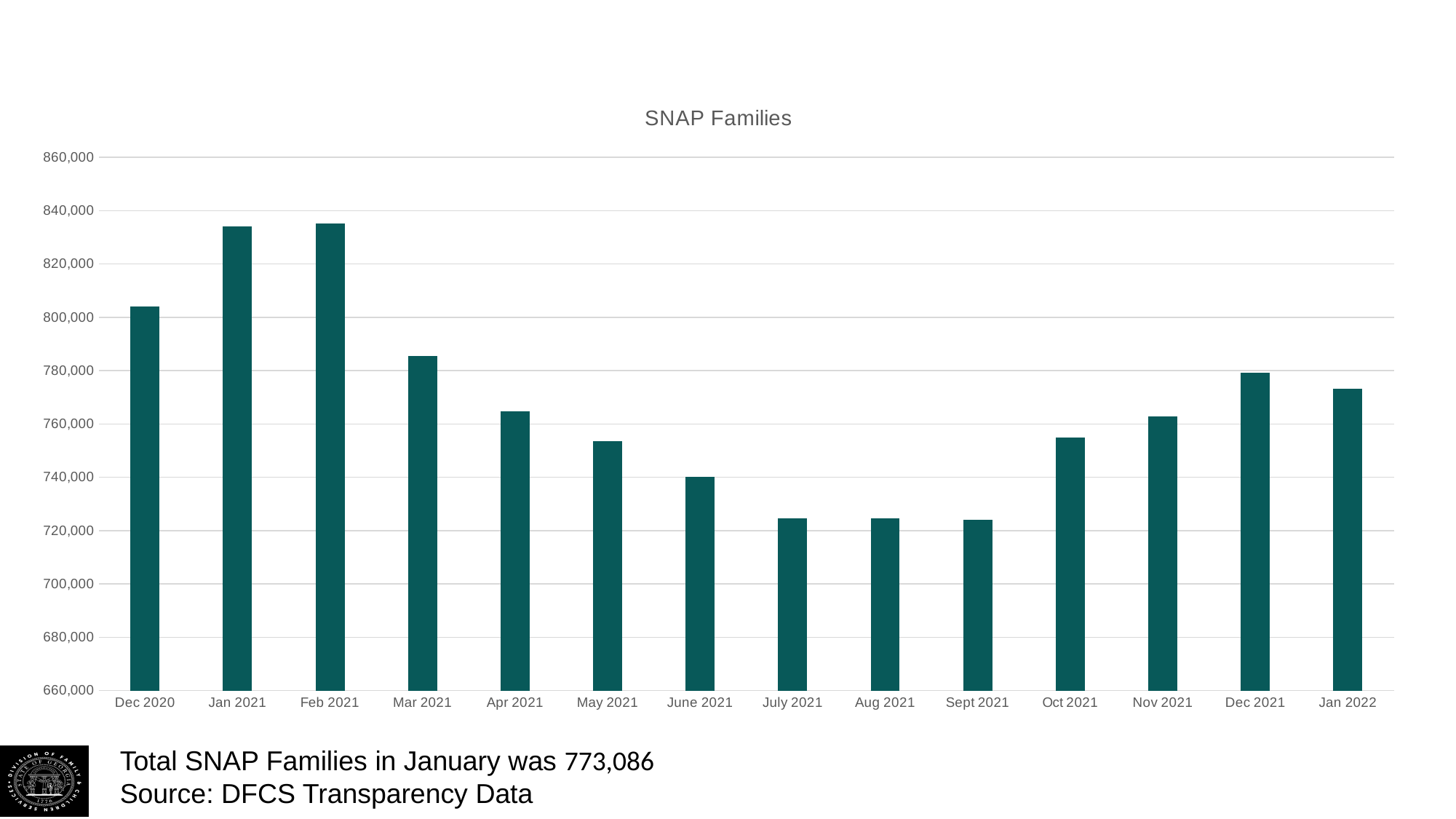
What is the title of the chart? SNAP Families Is the value for Nov 2021 greater or less than 760,000? greater Which is larger, the value for Oct 2021 or the value for Nov 2021? Nov 2021 Which is larger, the value for Dec 2020 or the value for Mar 2021? Dec 2020 What source is cited for the chart data? DFCS Transparency Data What was the total number of SNAP Families in Jan 2022? 773,086 Is the value for July 2021 greater or less than 740,000? less Is the value for May 2021 greater or less than 760,000? less Do the values rise or fall from Feb 2021 to Sept 2021? fall What kind of chart is shown on the slide? bar chart How many months are plotted on the x axis of the chart? 14